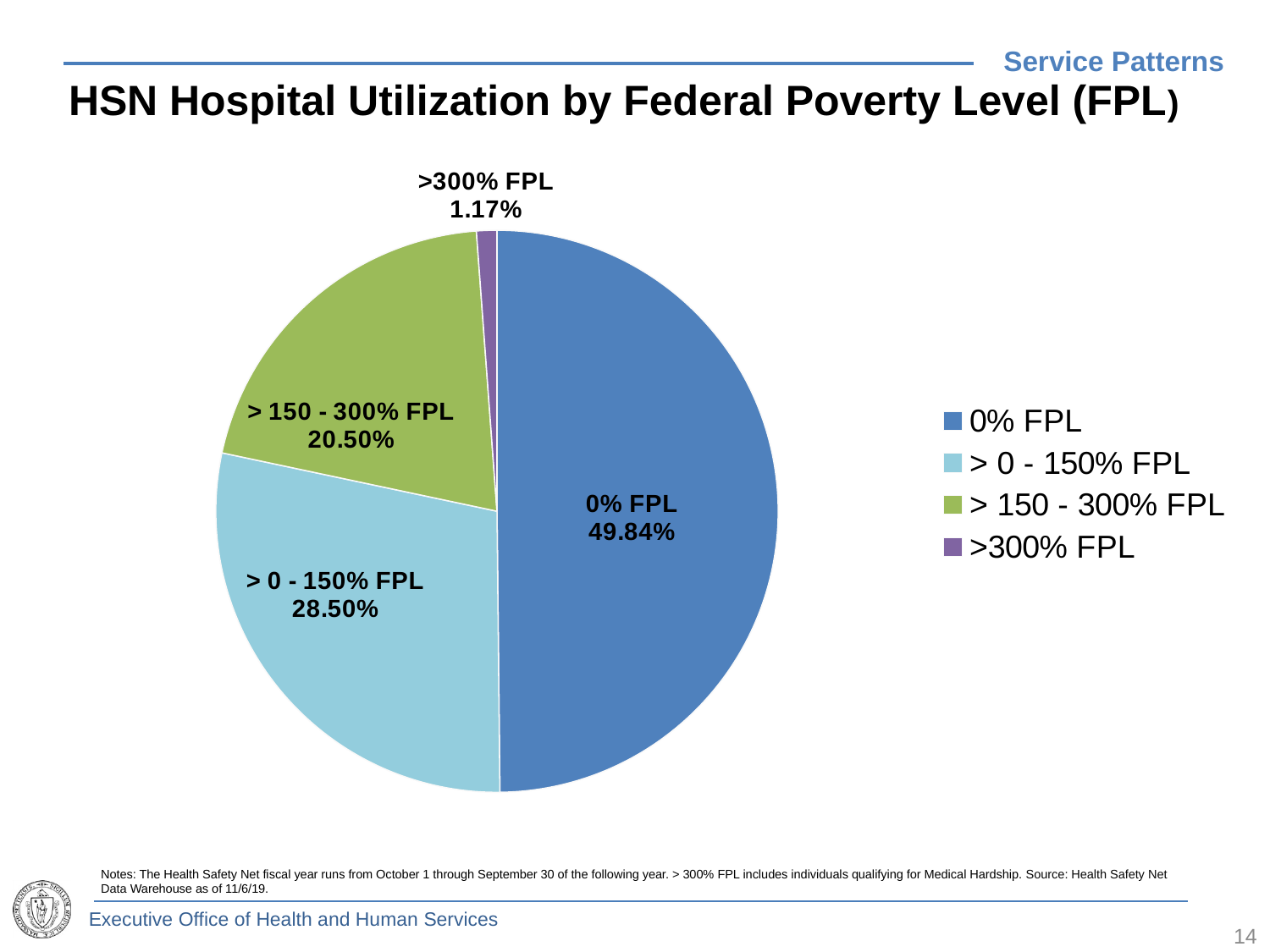
What share of HSN hospital utilization is for the > 150 - 300% FPL category? 20.50% What share of HSN hospital utilization is for the 0% FPL category? 49.84% Which FPL category has the largest share of HSN hospital utilization? 0% FPL Which has a larger share of HSN hospital utilization, > 150 - 300% FPL or >300% FPL? > 150 - 300% FPL What is the difference in percentage points between the > 0 - 150% FPL share and the > 150 - 300% FPL share? 8.00 How many FPL categories are shown in the pie chart? 4 What share of HSN hospital utilization is for the > 0 - 150% FPL category? 28.50% What type of chart is used to show HSN hospital utilization by Federal Poverty Level? Pie chart What is the difference in percentage points between the 0% FPL share and the > 0 - 150% FPL share? 21.34 What colour is the slice for the > 150 - 300% FPL category? Green Which FPL category has the smallest share of HSN hospital utilization? >300% FPL What share of HSN hospital utilization is for the >300% FPL category? 1.17%